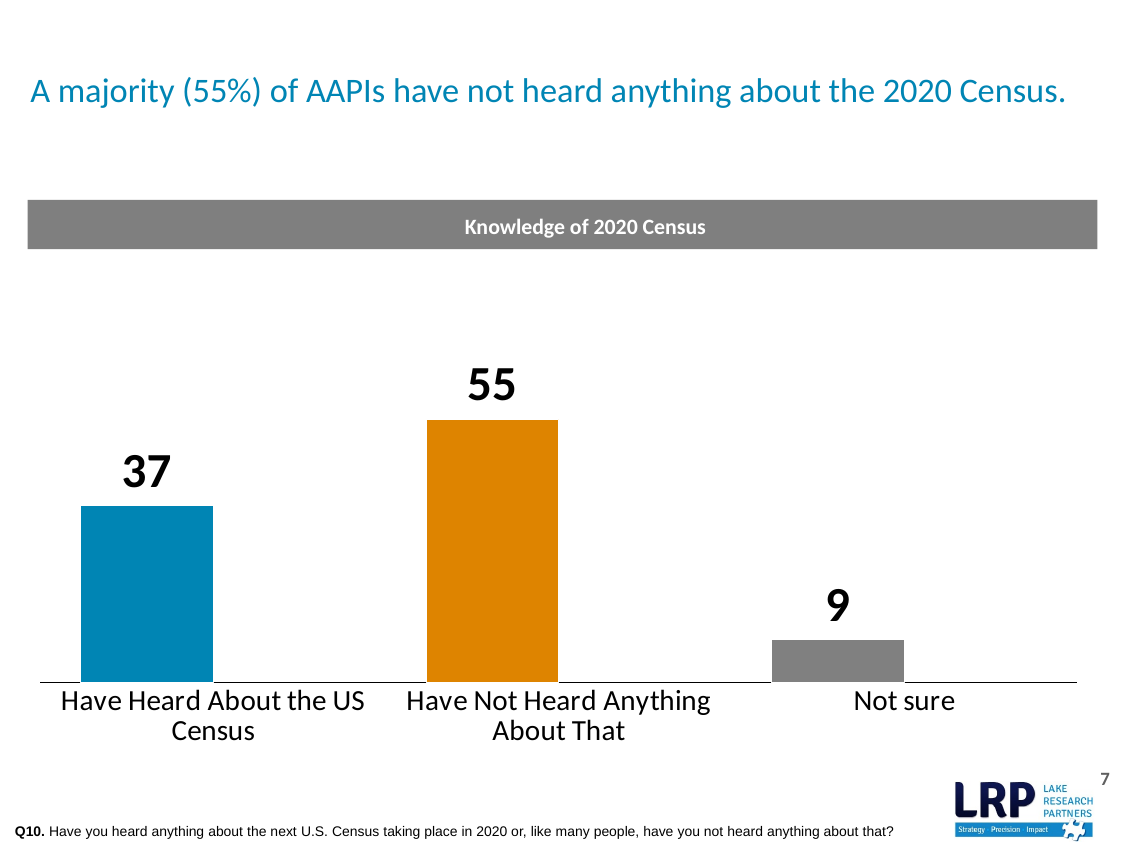
How many categories are shown in the chart? 3 What is the value for "Not sure"? 9 What is the difference between the values for "Have Heard About the US Census" and "Not sure"? 28 What is the title of the chart? Knowledge of 2020 Census What is the value for "Have Heard About the US Census"? 37 What is the difference between the values for "Have Not Heard Anything About That" and "Have Heard About the US Census"? 18 Which is larger: the value for "Have Heard About the US Census" or the value for "Not sure"? Have Heard About the US Census Which category has the highest value? Have Not Heard Anything About That What colour is the bar for "Have Not Heard Anything About That"? Orange Which category has the lowest value? Not sure What is the value for "Have Not Heard Anything About That"? 55 What kind of chart is shown on the slide? Bar chart